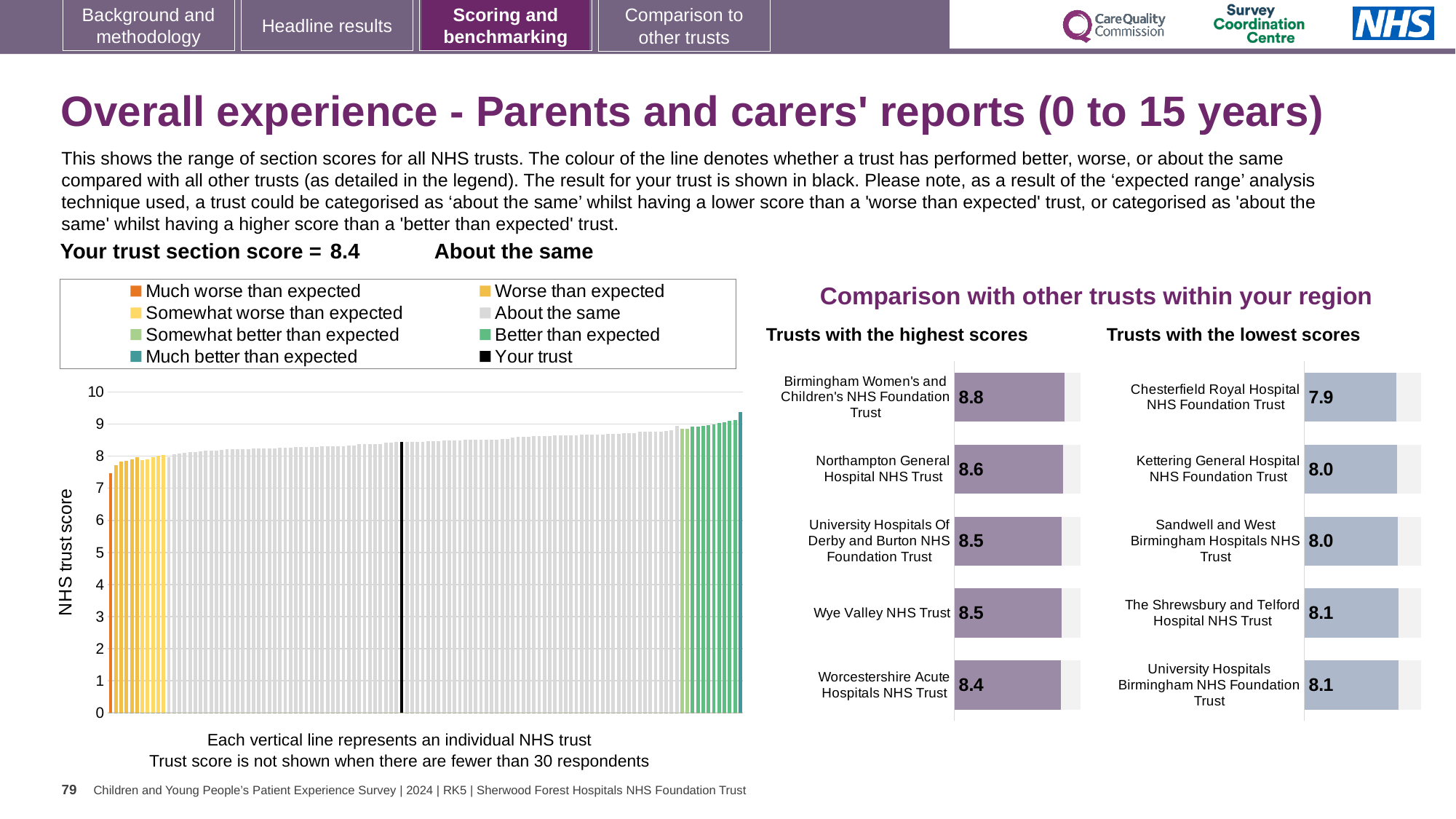
In the 'Trusts with the lowest scores' chart, what is the score for Chesterfield Royal Hospital NHS Foundation Trust? 7.9 In the 'Trusts with the highest scores' chart, what is the score for Birmingham Women's and Children's NHS Foundation Trust? 8.8 In the 'Trusts with the lowest scores' chart, which trust has the lowest score? Chesterfield Royal Hospital NHS Foundation Trust In the large 'NHS trust score' chart on the left, do the values rise or fall from left to right along the x axis? Rise In the 'Trusts with the lowest scores' chart, which has the higher score: Kettering General Hospital NHS Foundation Trust or The Shrewsbury and Telford Hospital NHS Trust? The Shrewsbury and Telford Hospital NHS Trust How many trusts are shown in the 'Trusts with the highest scores' chart? 5 In the large 'NHS trust score' chart on the left, is the value of the leftmost (orange) bar greater or less than 8? less In the 'Trusts with the highest scores' chart, what is the difference between the scores of Birmingham Women's and Children's NHS Foundation Trust and Worcestershire Acute Hospitals NHS Trust? 0.4 How many entries does the legend of the large 'NHS trust score' chart list? 8 In the 'Trusts with the lowest scores' chart, what is the score for Sandwell and West Birmingham Hospitals NHS Trust? 8.0 What kind of chart is the large 'NHS trust score' chart on the left? Bar chart In the 'Trusts with the highest scores' chart, which trust has the highest score? Birmingham Women's and Children's NHS Foundation Trust